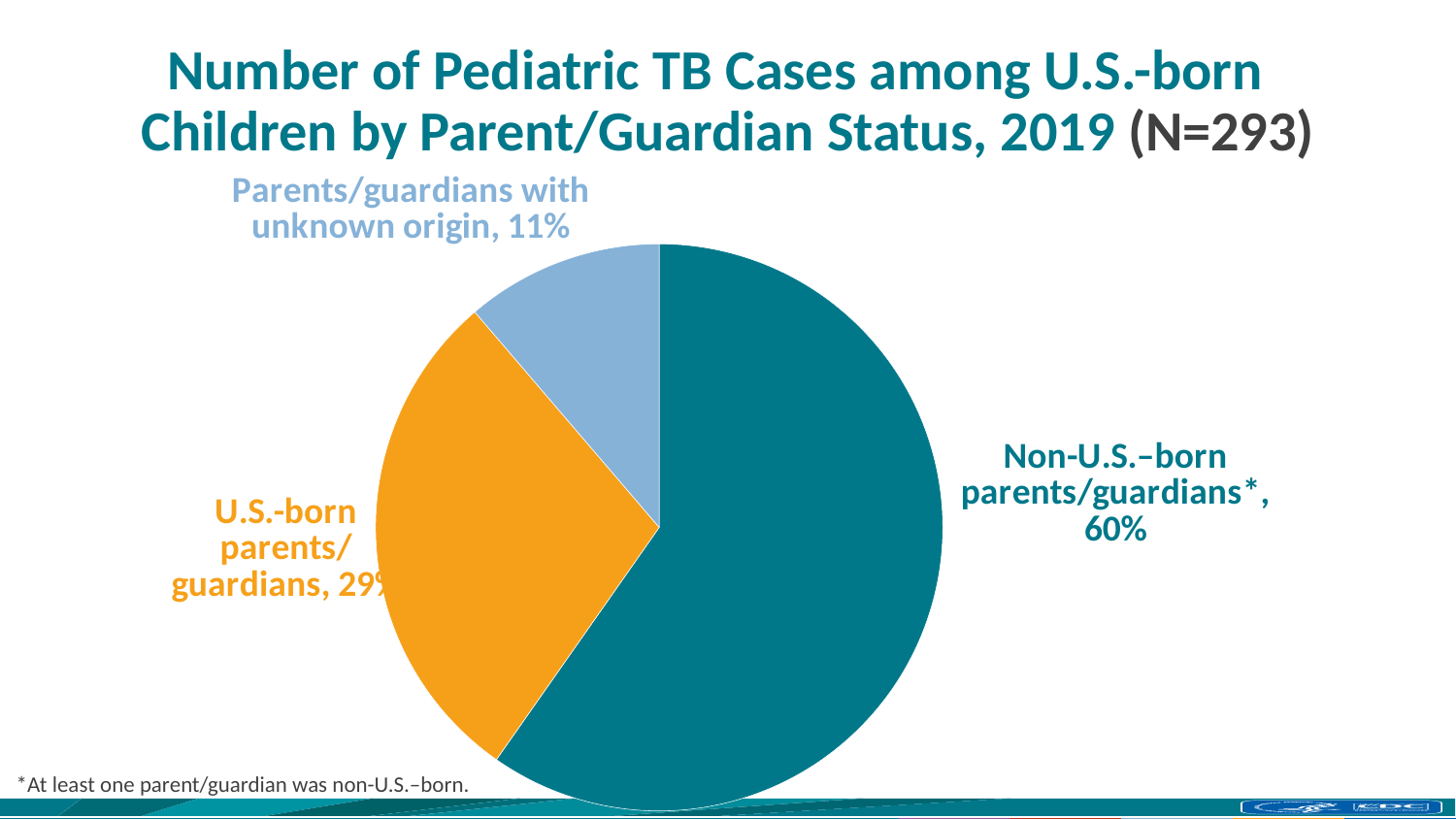
Which parent/guardian status category has the largest share of the pie? Non-U.S.-born parents/guardians What is the combined share of the U.S.-born parents/guardians and unknown origin slices? 40% Which is larger: the share for U.S.-born parents/guardians or the share for parents/guardians with unknown origin? U.S.-born parents/guardians How many slices does the pie chart have? 3 What share of pediatric TB cases had U.S.-born parents/guardians? 29% What colour is the slice for non-U.S.-born parents/guardians? Teal What kind of chart is shown on the slide? Pie chart Which parent/guardian status category has the smallest share of the pie? Parents/guardians with unknown origin What is the total number of cases (N) given in the chart title? 293 What share of pediatric TB cases had non-U.S.-born parents/guardians? 60% What is the difference in percentage points between the non-U.S.-born parents/guardians slice and the U.S.-born parents/guardians slice? 31 percentage points What share of pediatric TB cases had parents/guardians with unknown origin? 11%